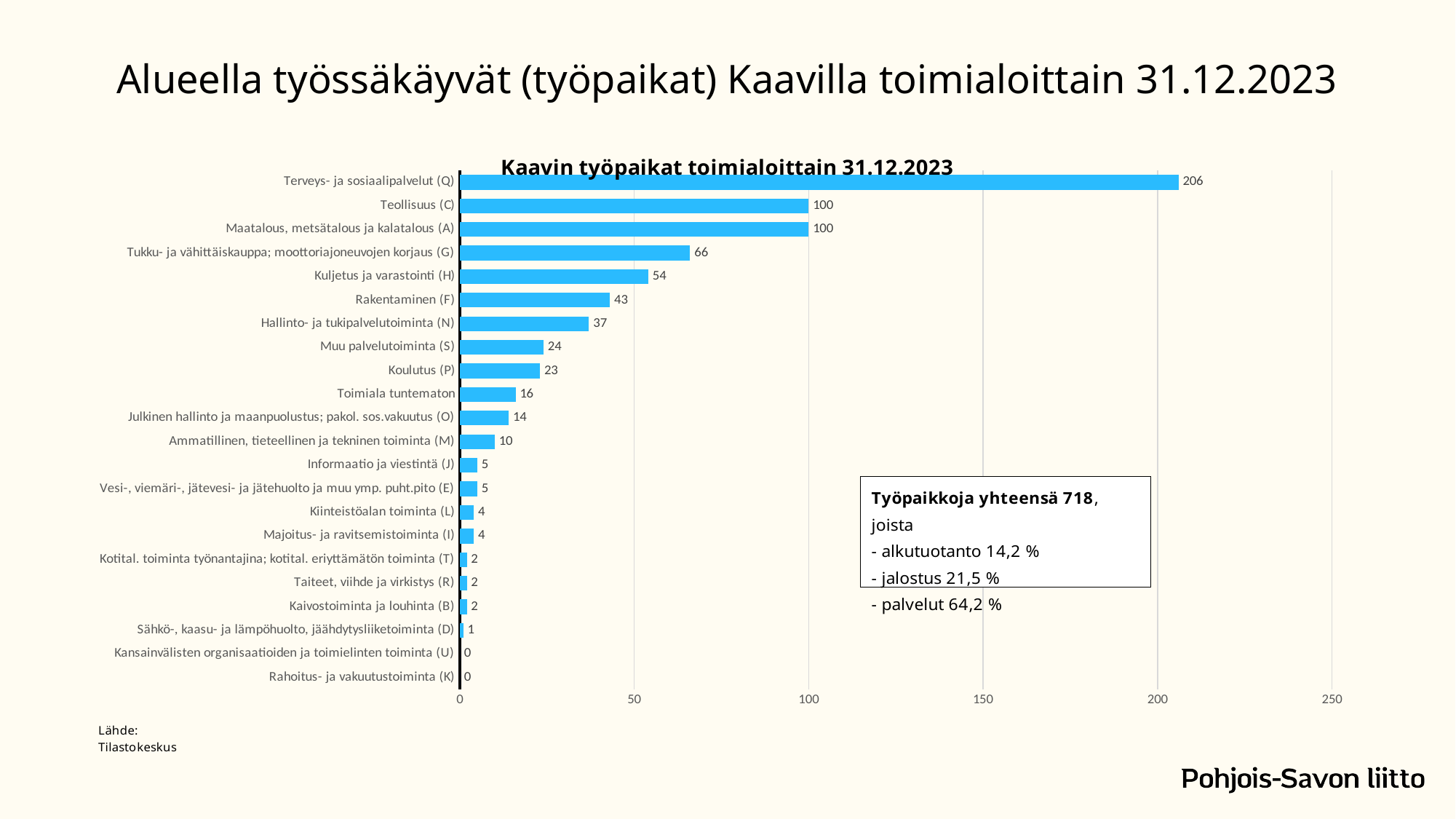
Which is larger, Hallinto- ja tukipalvelutoiminta (N) or Muu palvelutoiminta (S)? Hallinto- ja tukipalvelutoiminta (N) What kind of chart is shown on the slide? bar chart Which category has the highest value? Terveys- ja sosiaalipalvelut (Q) How many categories are shown in the chart? 22 What is the value for Koulutus (P)? 23 What is the value for Terveys- ja sosiaalipalvelut (Q)? 206 What is the difference between Tukku- ja vähittäiskauppa; moottoriajoneuvojen korjaus (G) and Rakentaminen (F)? 23 Is the value for Terveys- ja sosiaalipalvelut (Q) greater or less than 200? greater What is the title of the chart? Kaavin työpaikat toimialoittain 31.12.2023 What is the difference between Terveys- ja sosiaalipalvelut (Q) and Teollisuus (C)? 106 What is the value for Toimiala tuntematon? 16 What is the value for Kuljetus ja varastointi (H)? 54